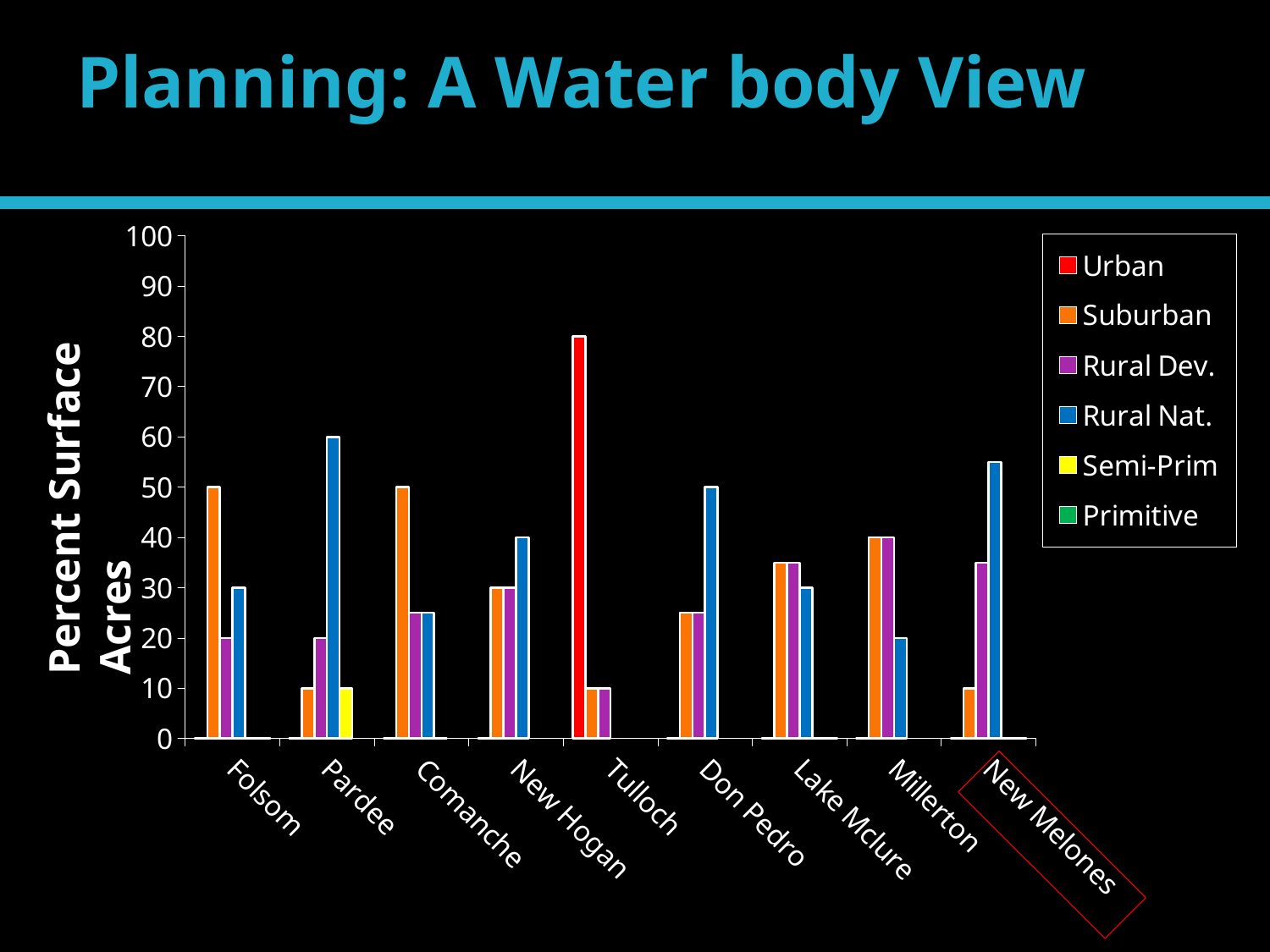
For Folsom, which is larger, the Suburban value or the Rural Nat. value? Suburban What kind of chart is shown on the slide? bar chart How many water bodies are shown along the x axis? 9 What is the Rural Nat. value for Pardee? 60 Is the Rural Nat. value for New Melones greater or less than 50? greater What is the Semi-Prim value for Pardee? 10 Is the Suburban value for Lake Mclure greater or less than 30? greater What is the difference between the Suburban and Rural Dev. values for Folsom? 30 Which x-axis label is outlined with a red box? New Melones How many series does the legend list? 6 Which water body has the tallest bar on the chart? Tulloch What is the Urban value for Tulloch? 80